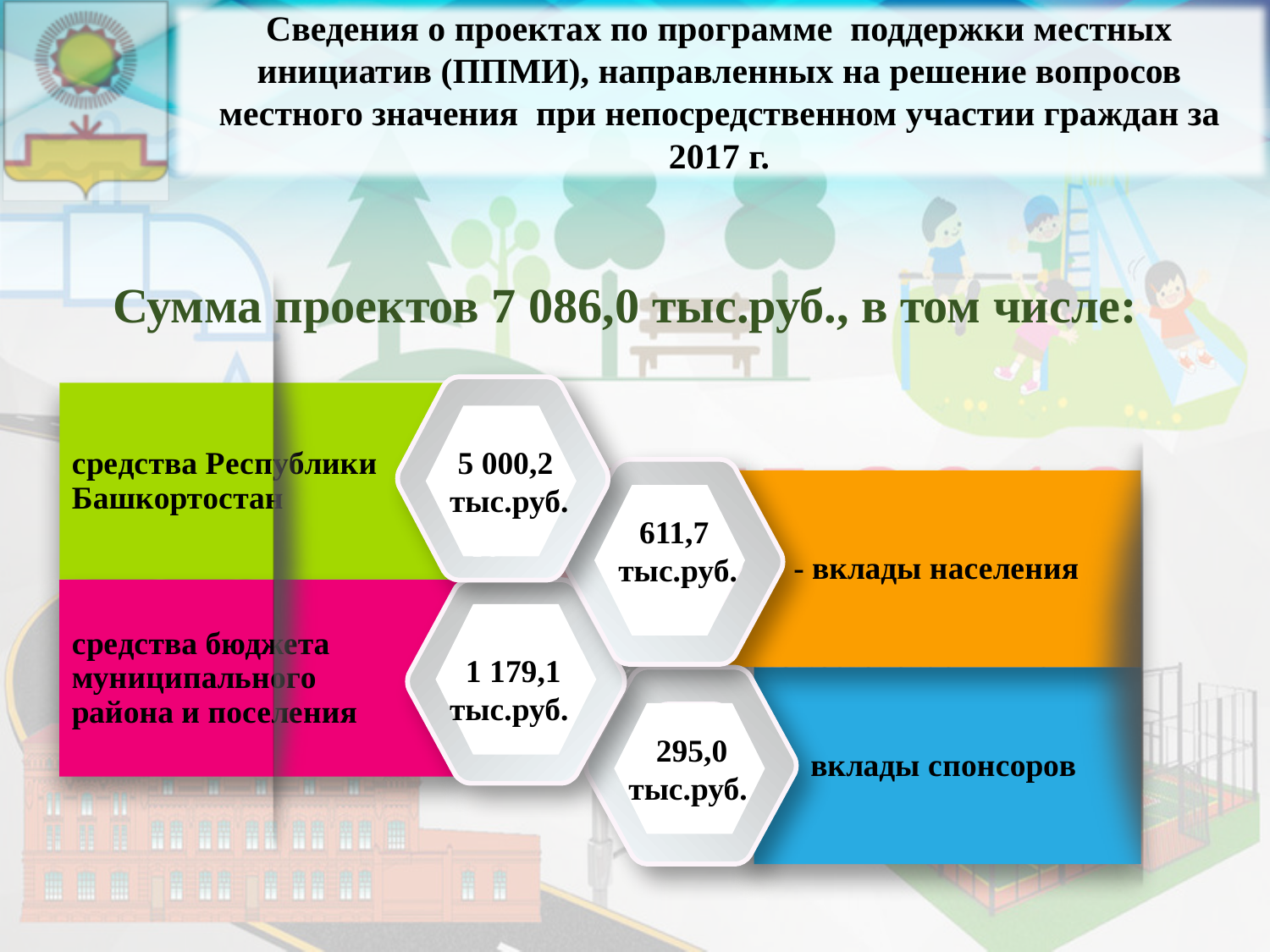
How many funding sources are shown in the diagram? 4 Which is larger: вклады населения or вклады спонсоров? вклады населения What is the value shown for средства Республики Башкортостан? 5 000,2 тыс.руб. What is the value shown for вклады населения? 611,7 тыс.руб. What is the value shown for средства бюджета муниципального района и поселения? 1 179,1 тыс.руб. What is the total sum of the projects stated on the slide? 7 086,0 тыс.руб. What colour is the block labelled вклады спонсоров? Blue Which funding source has the largest value? средства Республики Башкортостан What is the difference between средства Республики Башкортостан and средства бюджета муниципального района и поселения? 3 821,1 тыс.руб. What is the difference between вклады населения and вклады спонсоров? 316,7 тыс.руб. Which funding source has the smallest value? вклады спонсоров What is the value shown for вклады спонсоров? 295,0 тыс.руб.